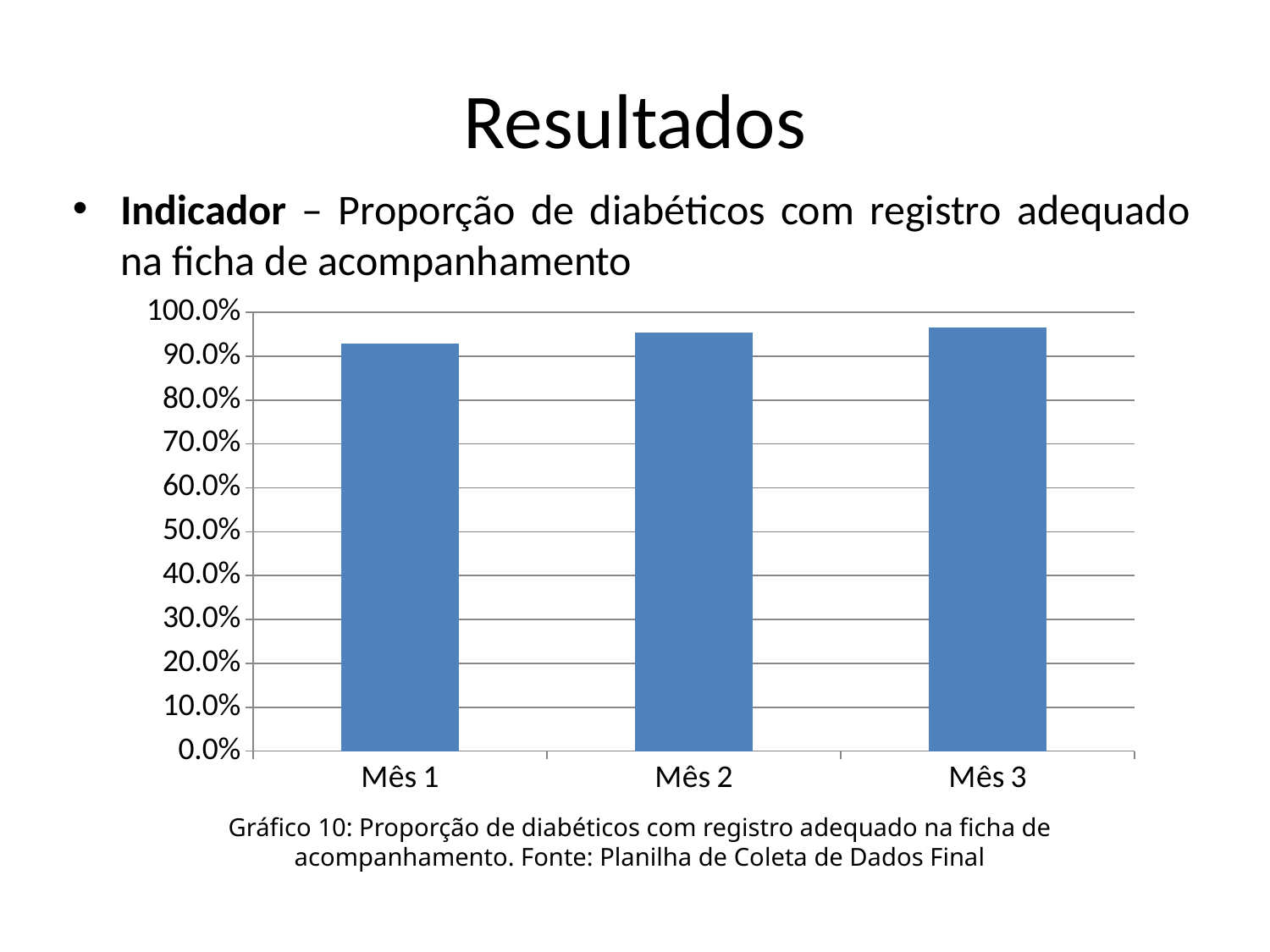
Is the value for Mês 2 greater or less than 90.0%? greater Is the value for Mês 3 greater or less than 100.0%? less Is the value for Mês 1 greater or less than 90.0%? greater Which month has the lowest proportion on the chart? Mês 1 What kind of chart is shown on the slide? bar chart Do the values rise or fall from Mês 1 to Mês 3? rise What is the highest value shown on the vertical axis of the chart? 100.0% Which is larger, the value for Mês 1 or the value for Mês 3? Mês 3 How many categories (months) are plotted on the chart? 3 Which is larger, the value for Mês 1 or the value for Mês 2? Mês 2 What is the number of the graph given in the caption below the chart? Gráfico 10